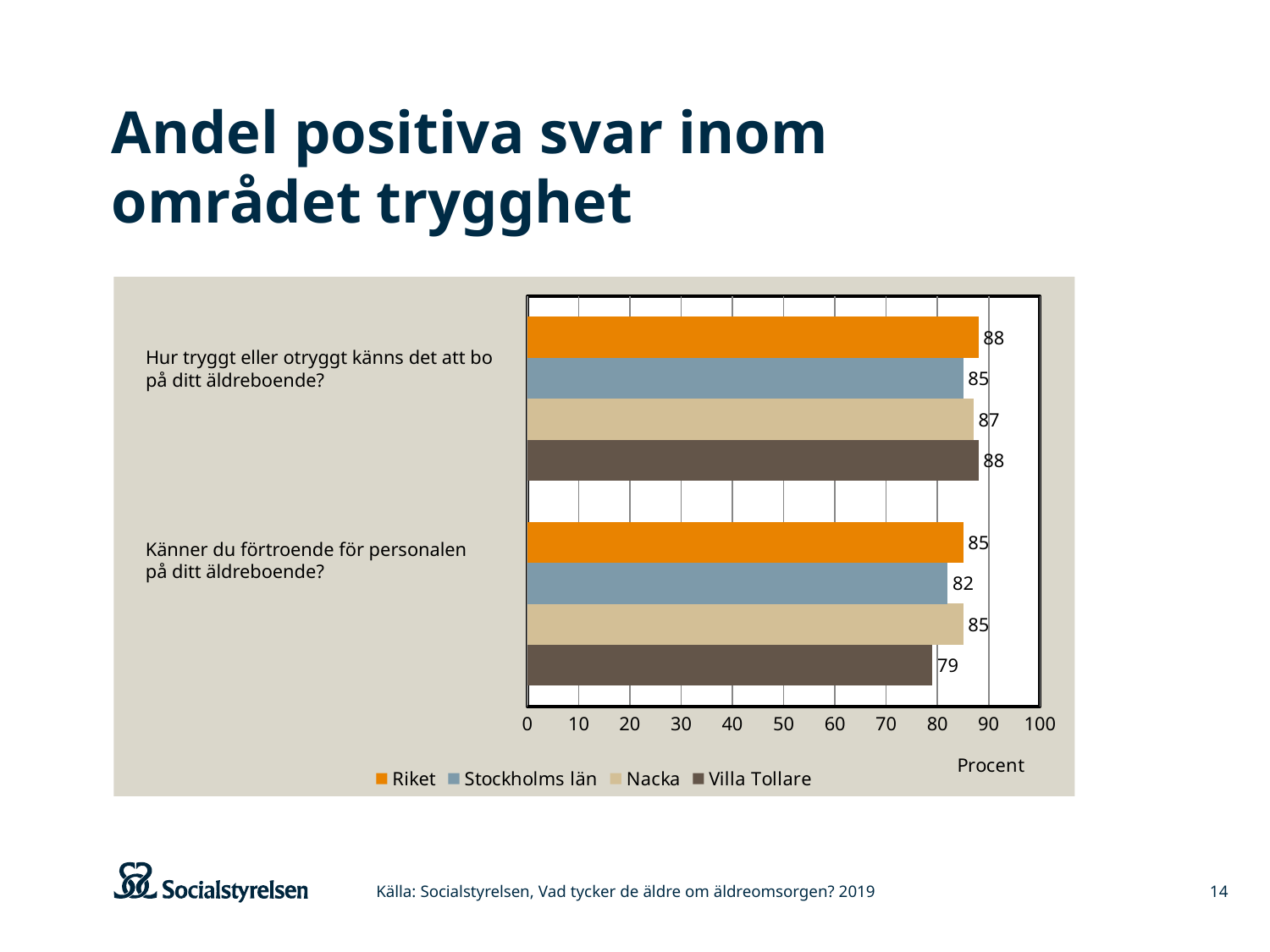
What is the value for Villa Tollare for "Känner du förtroende för personalen på ditt äldreboende?"? 79 What is the value for Stockholms län for "Känner du förtroende för personalen på ditt äldreboende?"? 82 What kind of chart is shown on the slide? bar chart What is the label of the x axis? Procent What is the value for Riket for "Hur tryggt eller otryggt känns det att bo på ditt äldreboende?"? 88 Which is larger for "Hur tryggt eller otryggt känns det att bo på ditt äldreboende?": Nacka or Stockholms län? Nacka What is the difference between Riket and Villa Tollare for "Känner du förtroende för personalen på ditt äldreboende?"? 6 How many question categories are shown on the y axis? 2 Which series has the lowest value for "Känner du förtroende för personalen på ditt äldreboende?"? Villa Tollare What is the value for Nacka for "Hur tryggt eller otryggt känns det att bo på ditt äldreboende?"? 87 How many series does the legend list? 4 Is the value for Villa Tollare for "Känner du förtroende för personalen på ditt äldreboende?" greater or less than 80? less